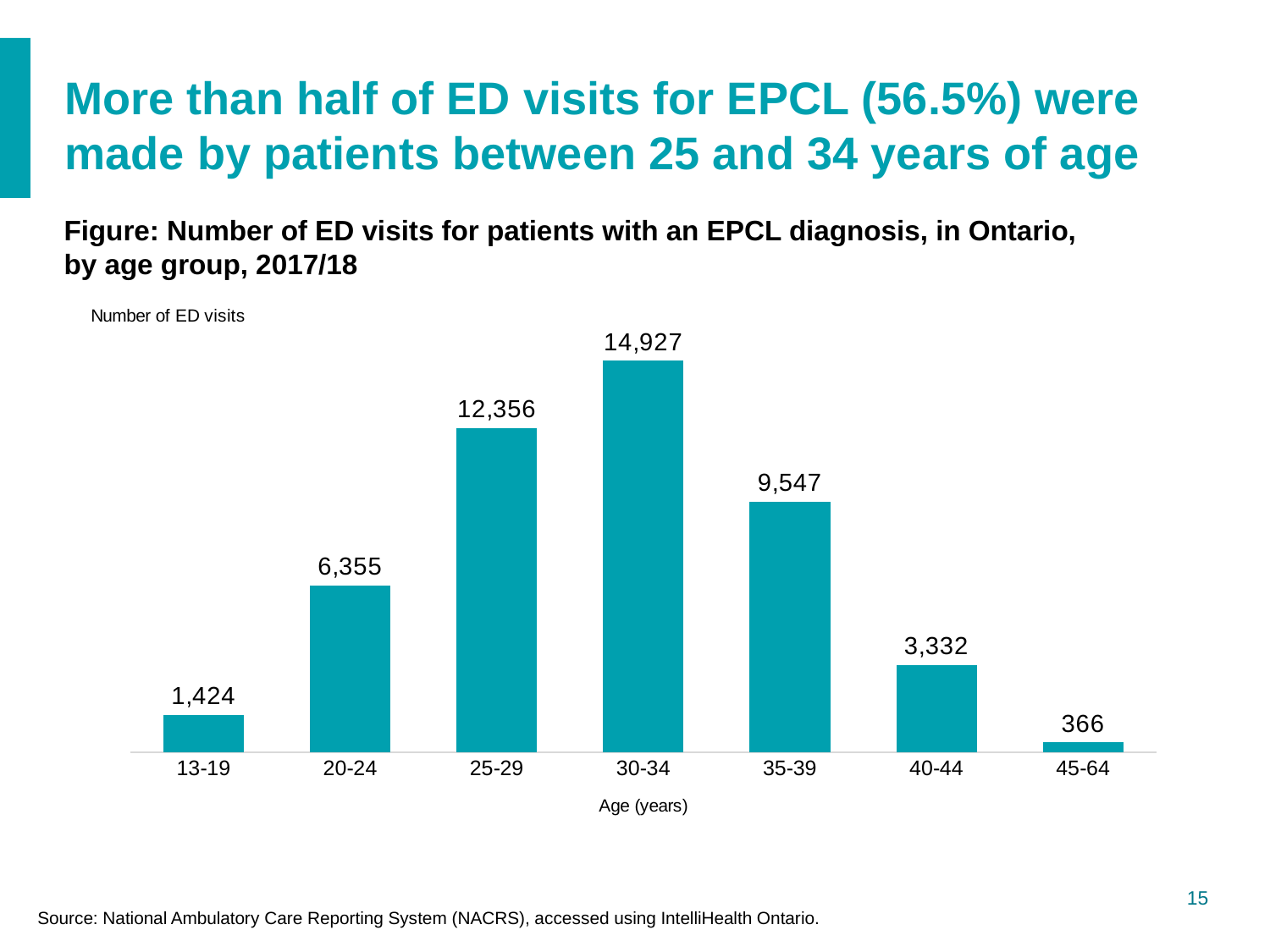
How many ED visits were recorded for the 45-64 age group? 366 What is the difference in ED visits between the 35-39 and 40-44 age groups? 6,215 Which age group has more ED visits, 20-24 or 35-39? 35-39 Which age group has the lowest number of ED visits? 45-64 How many age groups are shown on the chart? 7 What is the label of the x axis? Age (years) Do the number of ED visits rise or fall from the 30-34 age group to the 45-64 age group? Fall What is the difference in ED visits between the 30-34 and 25-29 age groups? 2,571 How many ED visits were made by patients aged 30-34? 14,927 Which age group has the highest number of ED visits? 30-34 What is the number of ED visits for the 20-24 age group? 6,355 What type of chart is shown on the slide? Bar chart